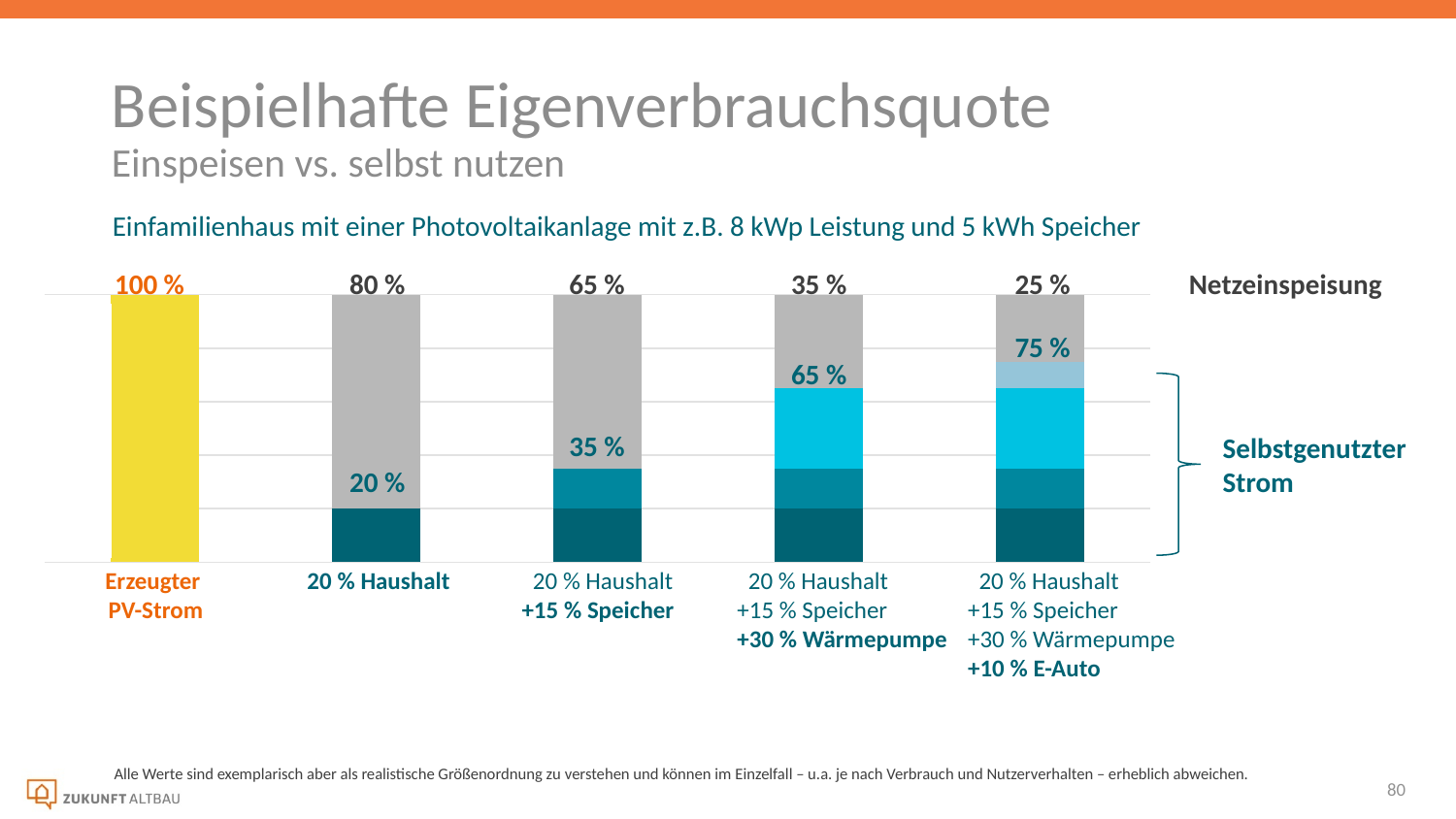
Which scenario has the lowest Netzeinspeisung share? 20 % Haushalt +15 % Speicher +30 % Wärmepumpe +10 % E-Auto Which scenario has the highest share of Selbstgenutzter Strom? 20 % Haushalt +15 % Speicher +30 % Wärmepumpe +10 % E-Auto By how many percentage points does the Netzeinspeisung share of the "20 % Haushalt" bar exceed that of the "20 % Haushalt +15 % Speicher" bar? 15 % What share of Selbstgenutzter Strom is shown for the bar that includes +10 % E-Auto? 75 % What value is shown above the yellow "Erzeugter PV-Strom" bar? 100 % What kind of chart is shown on the slide? Stacked bar chart What is the Netzeinspeisung share for the bar that includes +30 % Wärmepumpe (without E-Auto)? 35 % In the bar with +30 % Wärmepumpe (without E-Auto), which is larger: the Netzeinspeisung share or the Selbstgenutzter Strom share? Selbstgenutzter Strom What share of Selbstgenutzter Strom is shown for the bar labelled "20 % Haushalt +15 % Speicher"? 35 % How many bars are shown in the chart, including the Erzeugter PV-Strom bar? 5 Does the share of Selbstgenutzter Strom rise or fall from left to right across the scenario bars? Rises What is the Netzeinspeisung share shown for the "20 % Haushalt" bar? 80 %